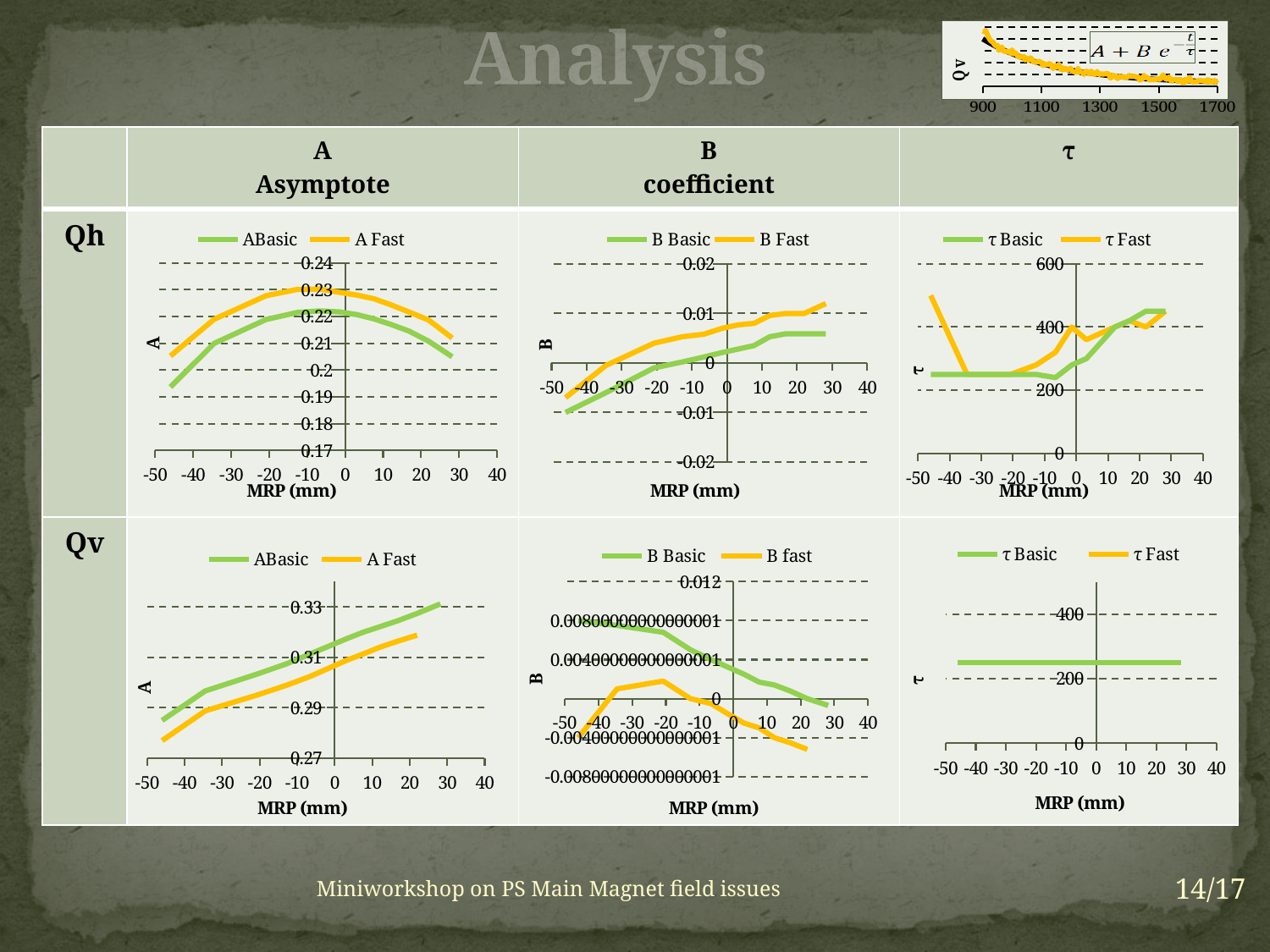
In the Qv A Asymptote chart (bottom-left), is the A Fast value at MRP -40 mm greater or less than 0.29? less What are the two legend entries of the Qv B coefficient chart (bottom-middle)? B Basic and B fast In the Qh τ chart (top-right), which series is higher at MRP -40 mm, τ Basic or τ Fast? τ Fast What kind of chart is the Qh A Asymptote chart (top-left)? line chart In the Qh B coefficient chart (top-middle), do the B Basic values rise or fall as MRP increases? rise In the Qh B coefficient chart (top-middle), is the B Basic value at MRP -40 mm greater or less than 0? less In the Qv τ chart (bottom-right), is the τ Basic value greater or less than 400? less In the Qv A Asymptote chart (bottom-left), do the ABasic values rise or fall as MRP increases? rise How many series does the legend of the Qh A Asymptote chart (top-left) list? 2 In the Qh A Asymptote chart (top-left), which series is higher at MRP 0 mm, ABasic or A Fast? A Fast